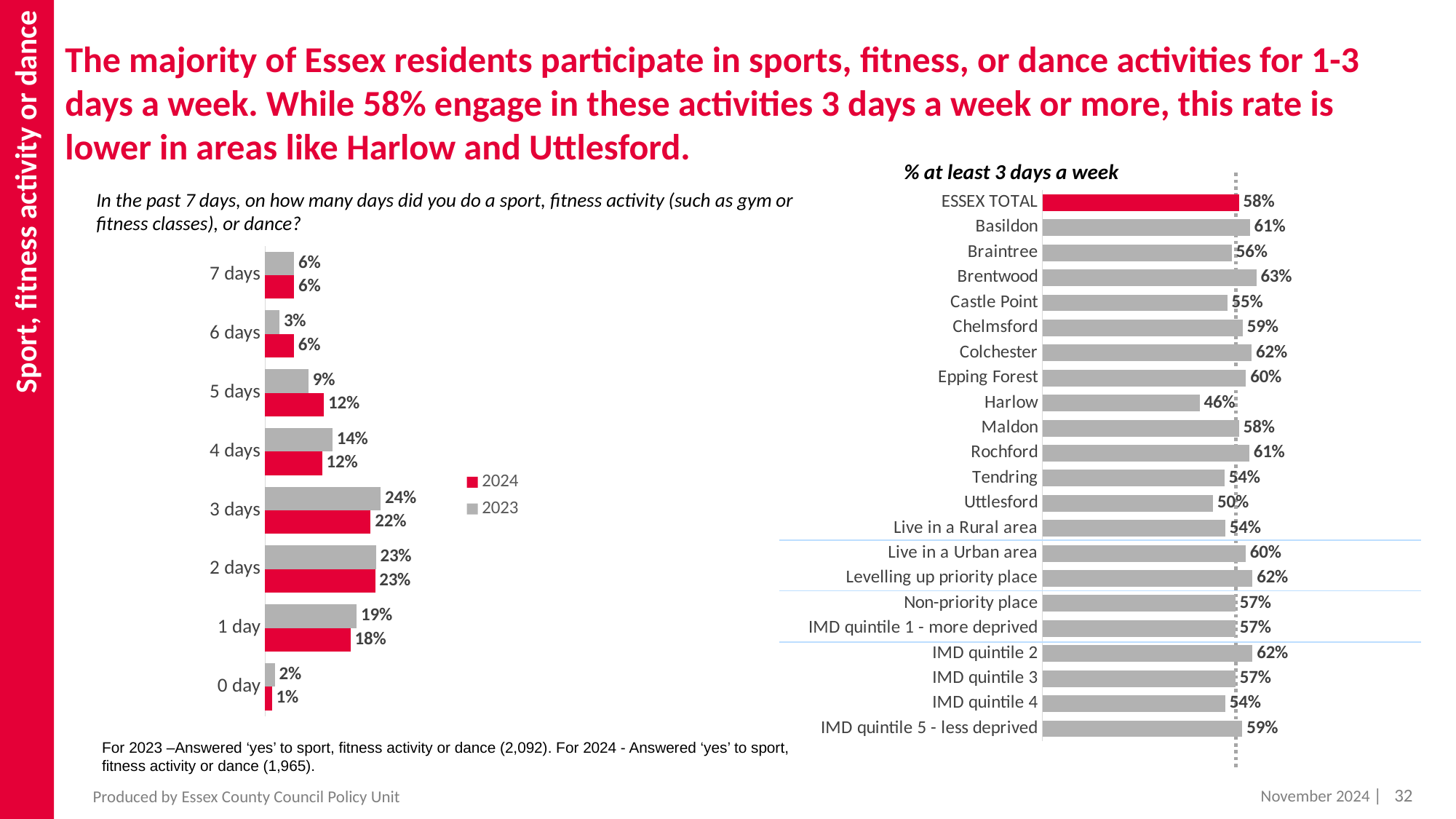
In the left chart on days of sport, fitness or dance activity, which category has the lowest 2024 value? 0 day In the left chart on days of sport, fitness or dance activity, what is the 2023 value for 1 day? 19% In the left chart on days of sport, fitness or dance activity, how many series does the legend list? 2 In the left chart on days of sport, fitness or dance activity, what is the 2024 value for 3 days? 22% In the left chart on days of sport, fitness or dance activity, which category has the highest 2023 value? 3 days In the '% at least 3 days a week' chart, what is the value for Harlow? 46% In the '% at least 3 days a week' chart, which district has the highest value? Brentwood In the '% at least 3 days a week' chart, which category has the lowest value? Harlow What type of chart is the '% at least 3 days a week' chart? Bar chart In the '% at least 3 days a week' chart, what is the difference between Essex Total and Uttlesford? 8% In the left chart on days of sport, fitness or dance activity, what is the difference between the 2024 and 2023 values for 6 days? 3% In the left chart on days of sport, fitness or dance activity, how many day categories are shown? 8